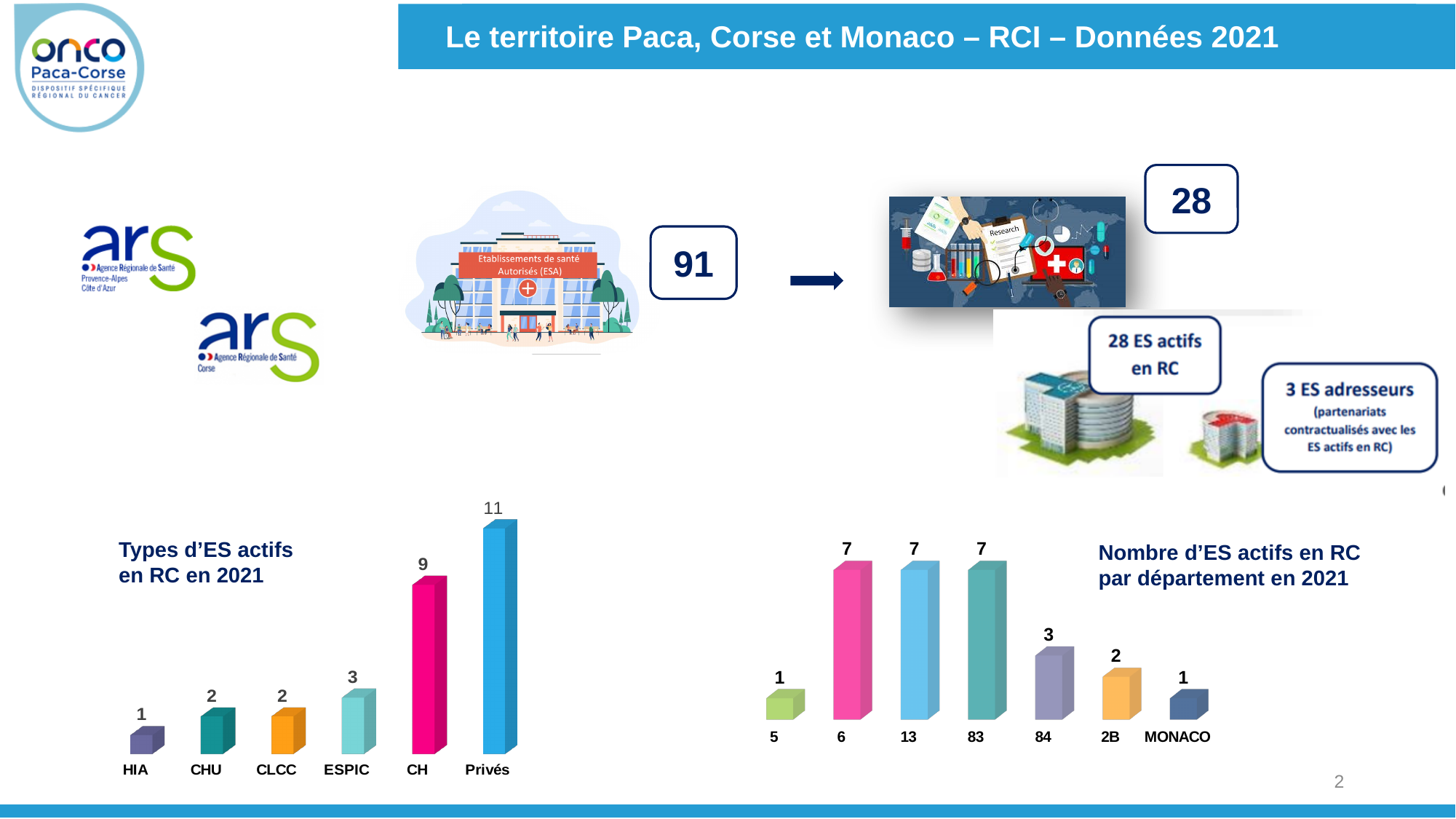
In the chart 'Types d'ES actifs en RC en 2021', how many categories are shown? 6 In the chart 'Nombre d'ES actifs en RC par département en 2021', what is the value for 84? 3 In the chart 'Types d'ES actifs en RC en 2021', which category has the lowest value? HIA In the chart 'Types d'ES actifs en RC en 2021', what is the value for ESPIC? 3 In the chart 'Types d'ES actifs en RC en 2021', which category has the highest value? Privés In the chart 'Types d'ES actifs en RC en 2021', what is the difference between the values for Privés and CH? 2 In the chart 'Nombre d'ES actifs en RC par département en 2021', what is the value for MONACO? 1 In the chart 'Nombre d'ES actifs en RC par département en 2021', how many categories are shown? 7 In the chart 'Nombre d'ES actifs en RC par département en 2021', what is the difference between the values for 6 and 2B? 5 In the chart 'Nombre d'ES actifs en RC par département en 2021', which is larger, the value for 2B or the value for 84? 84 In the chart 'Types d'ES actifs en RC en 2021', what is the value for CH? 9 What kind of chart is 'Types d'ES actifs en RC en 2021'? Bar chart